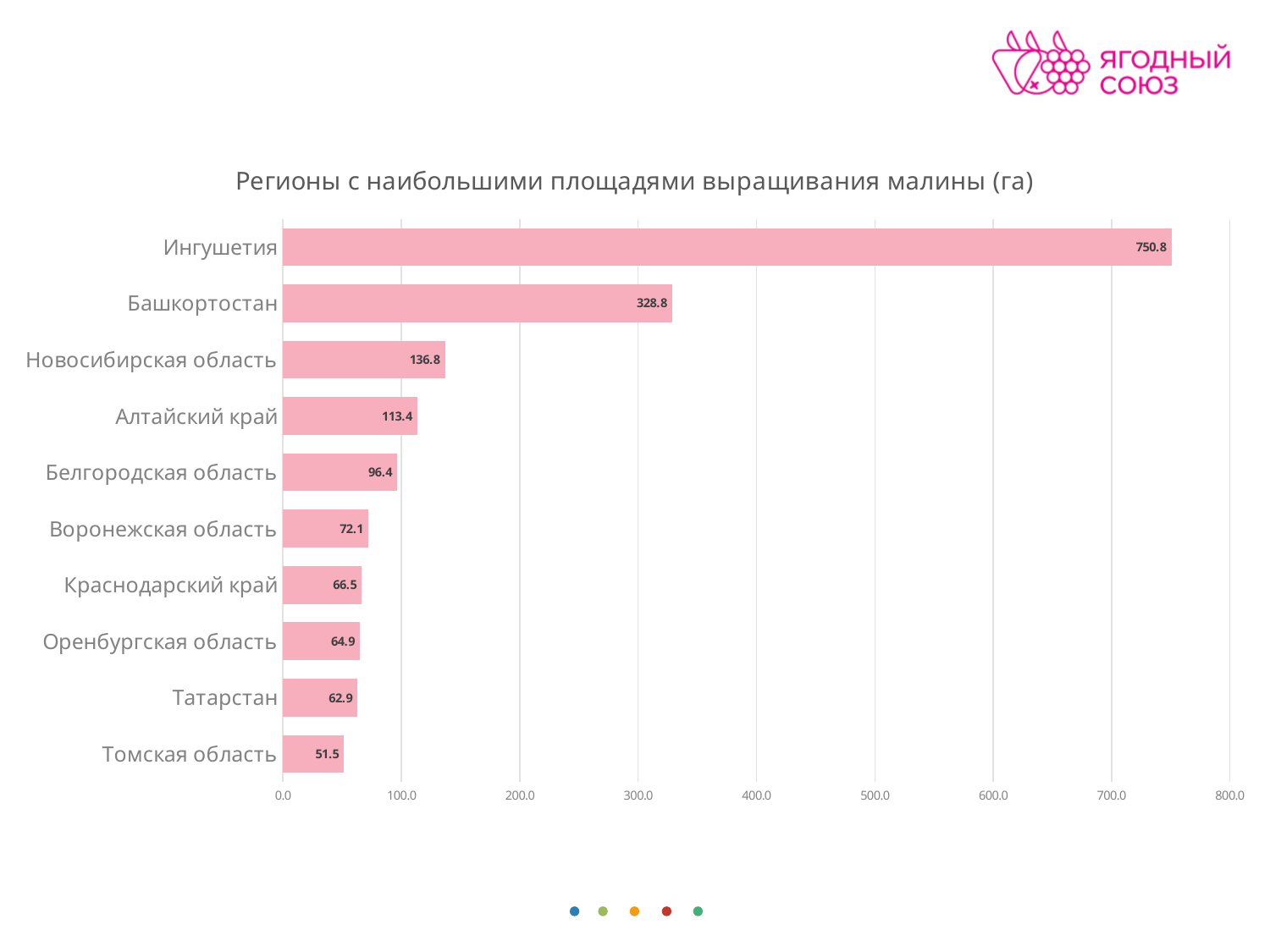
What is the value for Ингушетия? 750.8 What is the value for Новосибирская область? 136.8 How many regions are shown in the chart? 10 Is the value for Башкортостан greater or less than 300.0? greater What is the value for Томская область? 51.5 Which region has the highest value? Ингушетия Which region has the lowest value? Томская область What kind of chart is shown on the slide? bar chart What is the title of the chart? Регионы с наибольшими площадями выращивания малины (га) Which is larger, the value for Алтайский край or the value for Белгородская область? Алтайский край What is the difference between the values for Ингушетия and Башкортостан? 422.0 What is the value for Башкортостан? 328.8